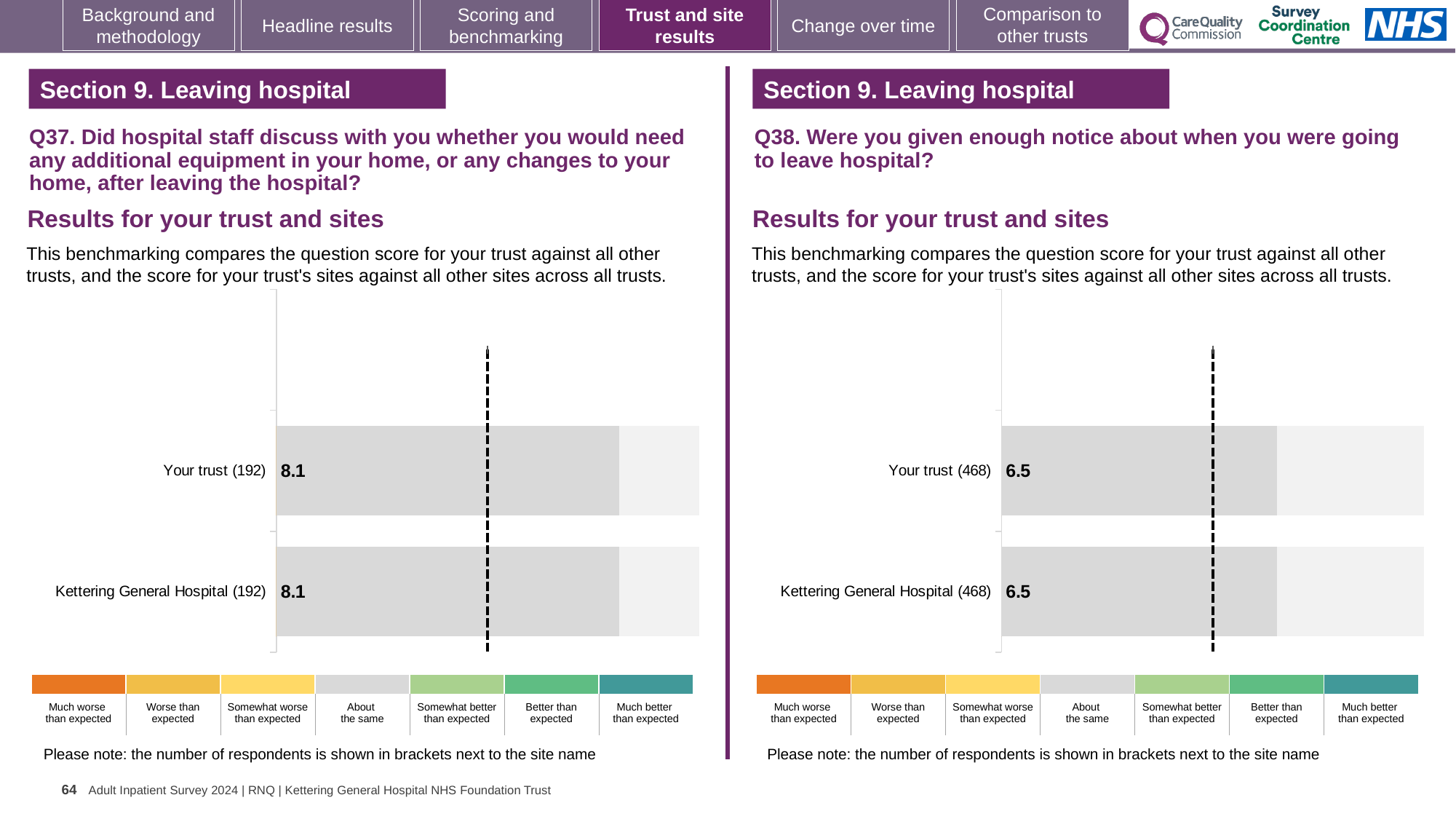
In the Q37 chart on the left, what is the difference between the score for Your trust and the score for Kettering General Hospital? 0 In the Q37 chart on the left, how many respondents are shown in brackets for Your trust? 192 In the Q37 chart on the left, what is the score for Kettering General Hospital? 8.1 How many bars are plotted in the Q38 chart on the right? 2 In the Q38 chart on the right, what is the score for Kettering General Hospital? 6.5 How many bars are plotted in the Q37 chart on the left? 2 In the Q37 chart on the left, what is the score for Your trust? 8.1 In the Q38 chart on the right, what is the score for Your trust? 6.5 What kind of chart is used for the Q37 results on the left? Bar chart In the Q38 chart on the right, what is the difference between the score for Your trust and the score for Kettering General Hospital? 0 How many rating bands are shown in the colour key below the Q38 chart on the right? 7 In the Q38 chart on the right, how many respondents are shown in brackets for Kettering General Hospital? 468